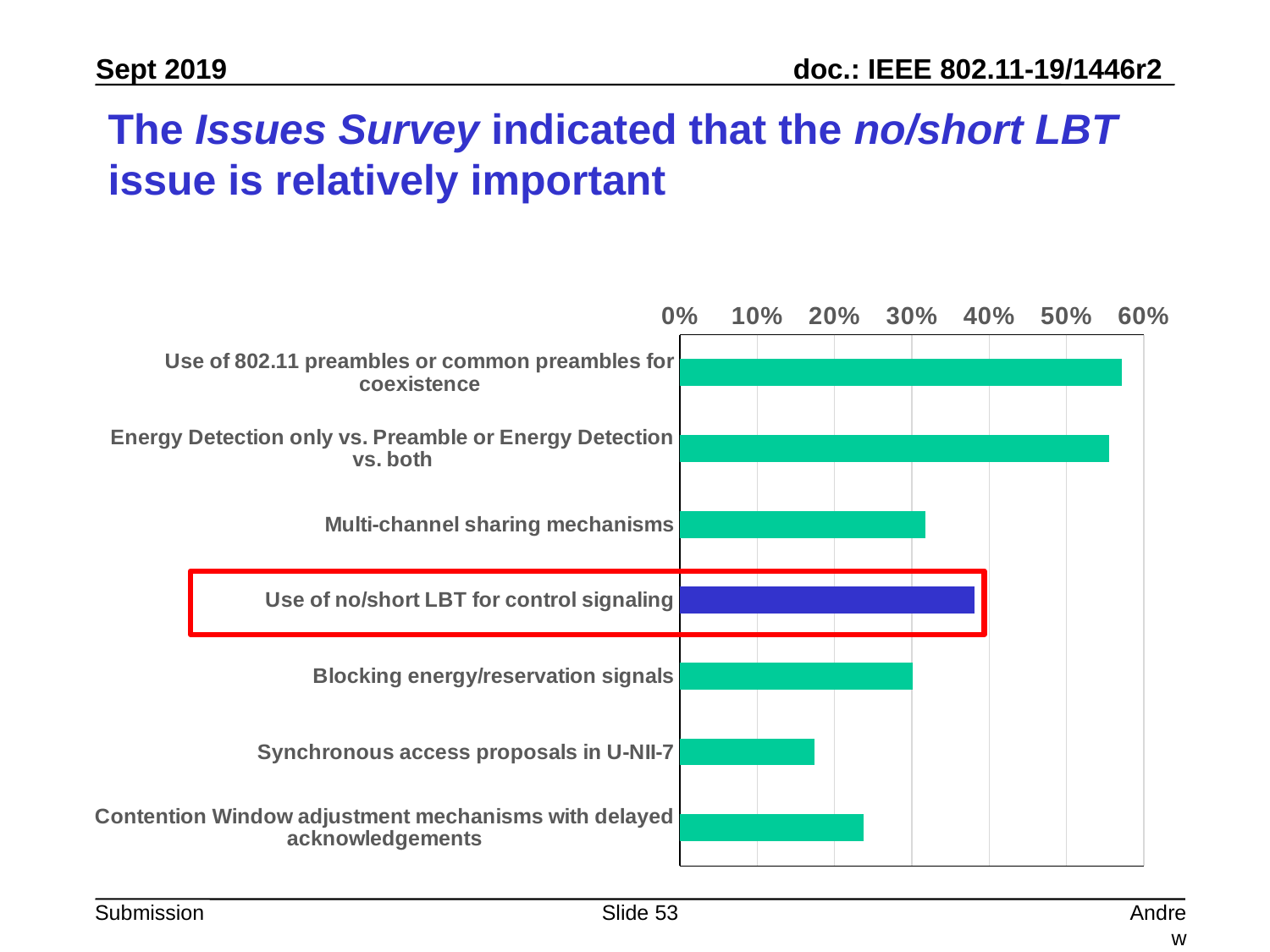
How many categories are plotted in the chart? 7 Is the value for 'Contention Window adjustment mechanisms with delayed acknowledgements' greater or less than 20%? greater Which is larger: the value for 'Blocking energy/reservation signals' or the value for 'Contention Window adjustment mechanisms with delayed acknowledgements'? Blocking energy/reservation signals Is the value for 'Synchronous access proposals in U-NII-7' greater or less than 20%? less Which category has the lowest value in the chart? Synchronous access proposals in U-NII-7 Which is larger: the value for 'Use of no/short LBT for control signaling' or the value for 'Multi-channel sharing mechanisms'? Use of no/short LBT for control signaling Is the value for 'Use of no/short LBT for control signaling' greater or less than 40%? less What kind of chart is shown on the slide? bar chart Which category's bar is highlighted with a red box and drawn in a different colour from the others? Use of no/short LBT for control signaling